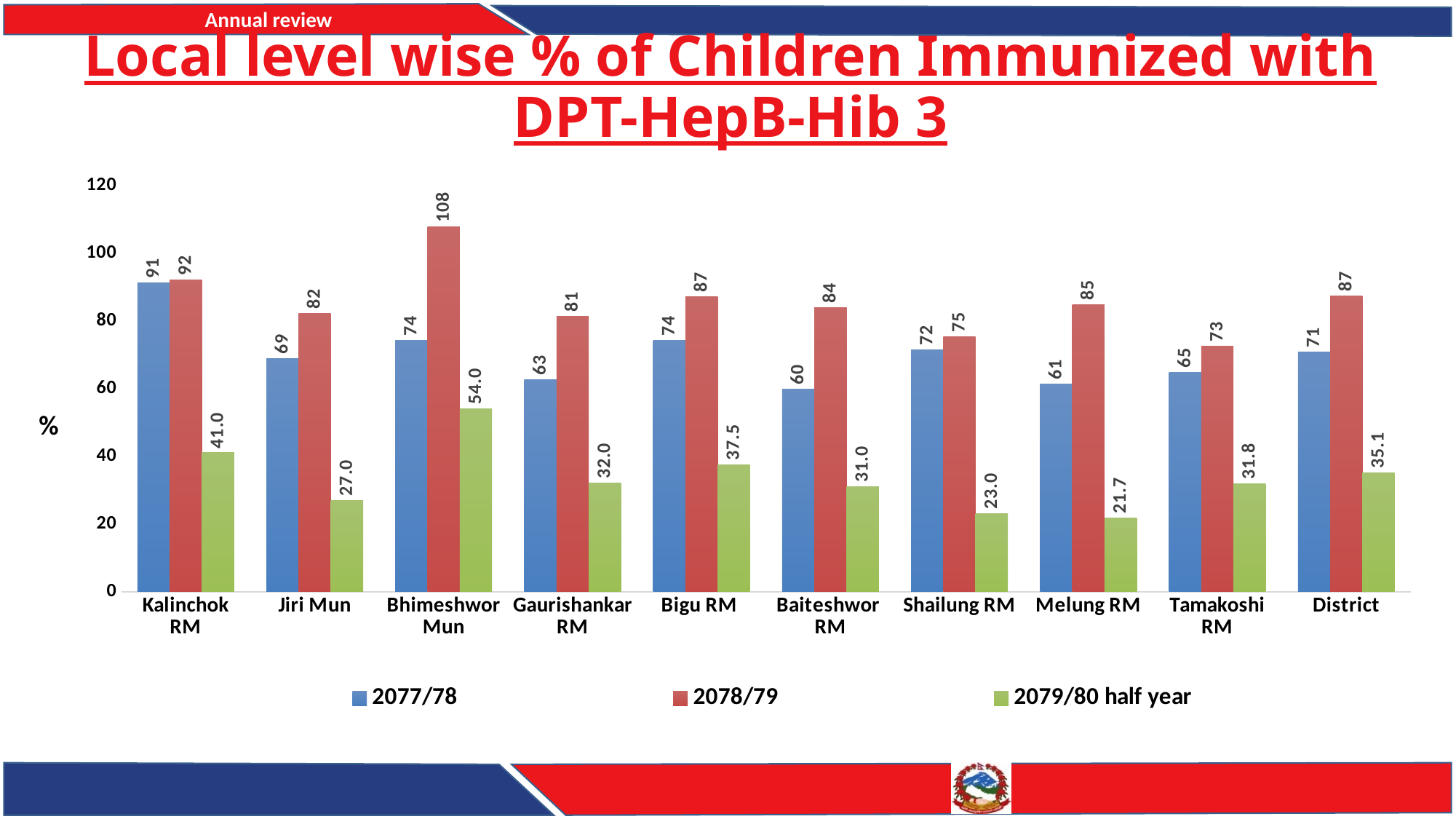
What is the value for Kalinchok RM in the 2077/78 series? 91 What is the value for Melung RM in the 2079/80 half year series? 21.7 How many local level categories are shown on the x axis? 10 What is the title of the chart? Local level wise % of Children Immunized with DPT-HepB-Hib 3 Which is larger for Jiri Mun: the 2077/78 value or the 2078/79 value? 2078/79 Which local level has the lowest value in the 2079/80 half year series? Melung RM What is the value for Bhimeshwor Mun in the 2078/79 series? 108 How many series does the legend list? 3 Which local level has the highest value in the 2078/79 series? Bhimeshwor Mun Is the 2079/80 half year value for Bhimeshwor Mun greater or less than 40? greater What kind of chart is shown on the slide? Bar chart What is the difference between the 2078/79 and 2077/78 values for Bhimeshwor Mun? 34